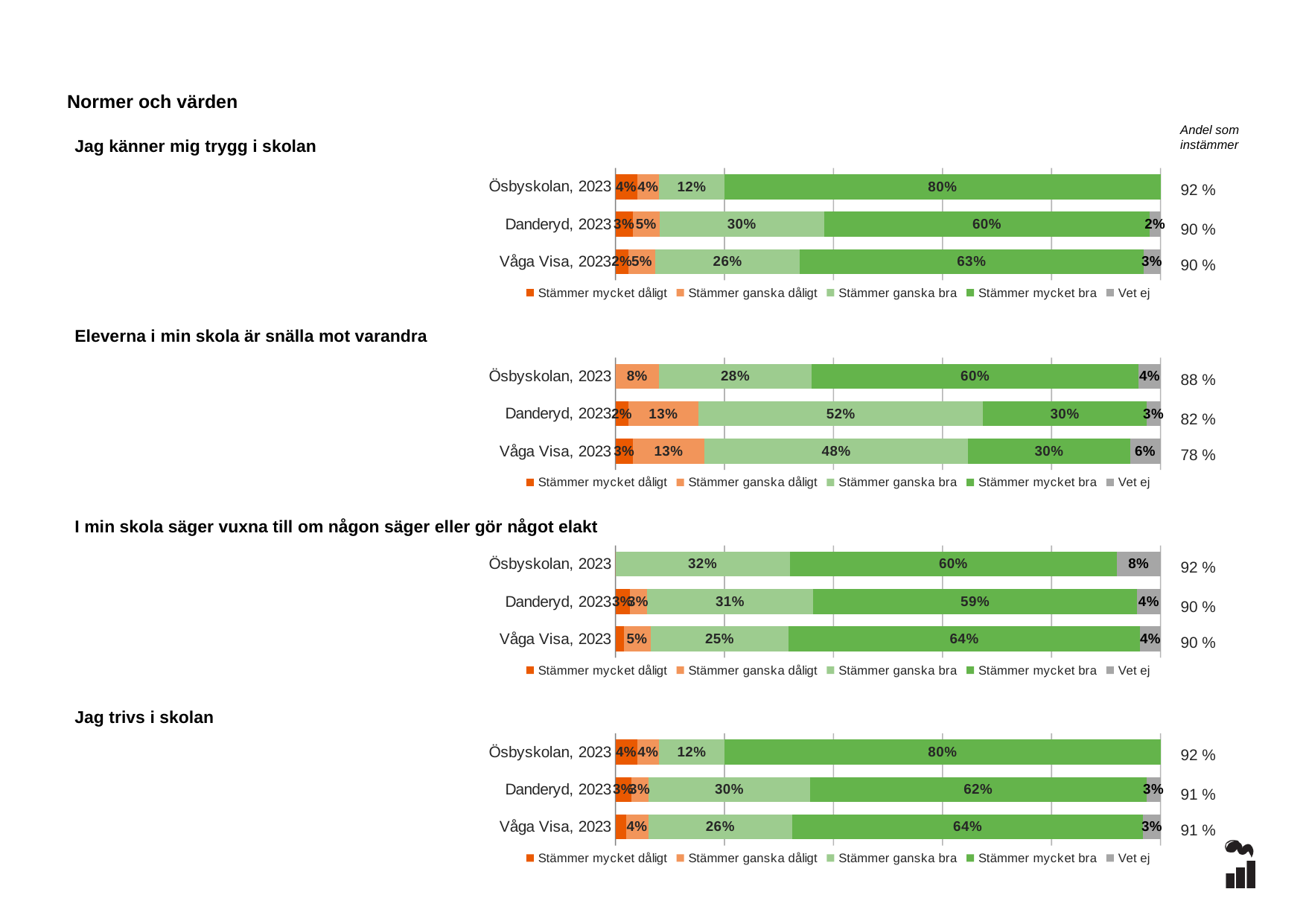
In the chart 'Eleverna i min skola är snälla mot varandra', what is the difference between the 'Stämmer ganska bra' values for Danderyd, 2023 and Våga Visa, 2023? 4% In the chart 'Jag trivs i skolan', what is the 'Stämmer mycket bra' value for Danderyd, 2023? 62% In the chart 'I min skola säger vuxna till om någon säger eller gör något elakt', what is the 'Vet ej' value for Ösbyskolan, 2023? 8% In the chart 'Jag känner mig trygg i skolan', what is the 'Stämmer ganska bra' value for Danderyd, 2023? 30% How many rows (bars) are shown in the chart 'Jag känner mig trygg i skolan'? 3 In the chart 'Eleverna i min skola är snälla mot varandra', what is the 'Vet ej' value for Våga Visa, 2023? 6% In the chart 'I min skola säger vuxna till om någon säger eller gör något elakt', which is larger: the 'Stämmer mycket bra' value for Våga Visa, 2023 or for Danderyd, 2023? Våga Visa, 2023 What kind of chart is used for 'Eleverna i min skola är snälla mot varandra'? Stacked bar chart In the chart 'Jag känner mig trygg i skolan', what is the 'Stämmer mycket bra' value for Ösbyskolan, 2023? 80% How many series does the legend list in the chart 'Jag trivs i skolan'? 5 In the chart 'Eleverna i min skola är snälla mot varandra', which row has the highest 'Stämmer mycket bra' value? Ösbyskolan, 2023 In the chart 'Jag trivs i skolan', what is the 'Stämmer ganska bra' value for Våga Visa, 2023? 26%